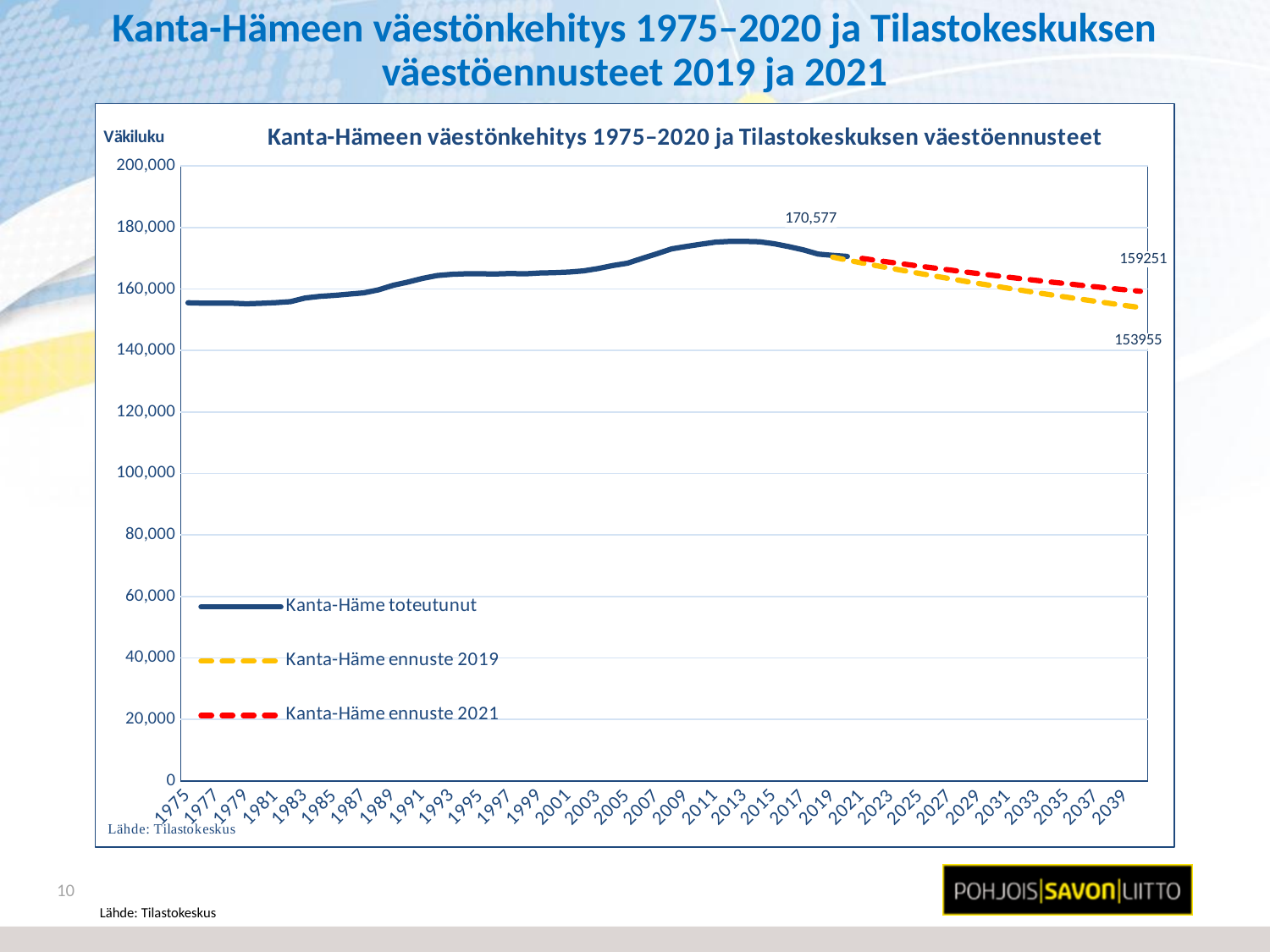
Is the value of the Kanta-Häme toteutunut series in 2013 greater or less than 170,000? greater What is the labelled end value of the Kanta-Häme ennuste 2021 series? 159251 Is the value of the Kanta-Häme toteutunut series in 1975 greater or less than 160,000? less What is the labelled value shown at the end of the Kanta-Häme toteutunut series? 170,577 What is the label on the vertical axis of the chart? Väkiluku What kind of chart is shown on the slide? line chart Which forecast series ends at a higher value, Kanta-Häme ennuste 2019 or Kanta-Häme ennuste 2021? Kanta-Häme ennuste 2021 Do the forecast series (ennuste 2019 and ennuste 2021) rise or fall from 2021 to 2039? fall What colour is the Kanta-Häme ennuste 2021 line in the chart? red What is the difference between the labelled end values of the Kanta-Häme ennuste 2021 and Kanta-Häme ennuste 2019 series? 5296 What is the labelled end value of the Kanta-Häme ennuste 2019 series? 153955 How many series does the chart legend list? 3